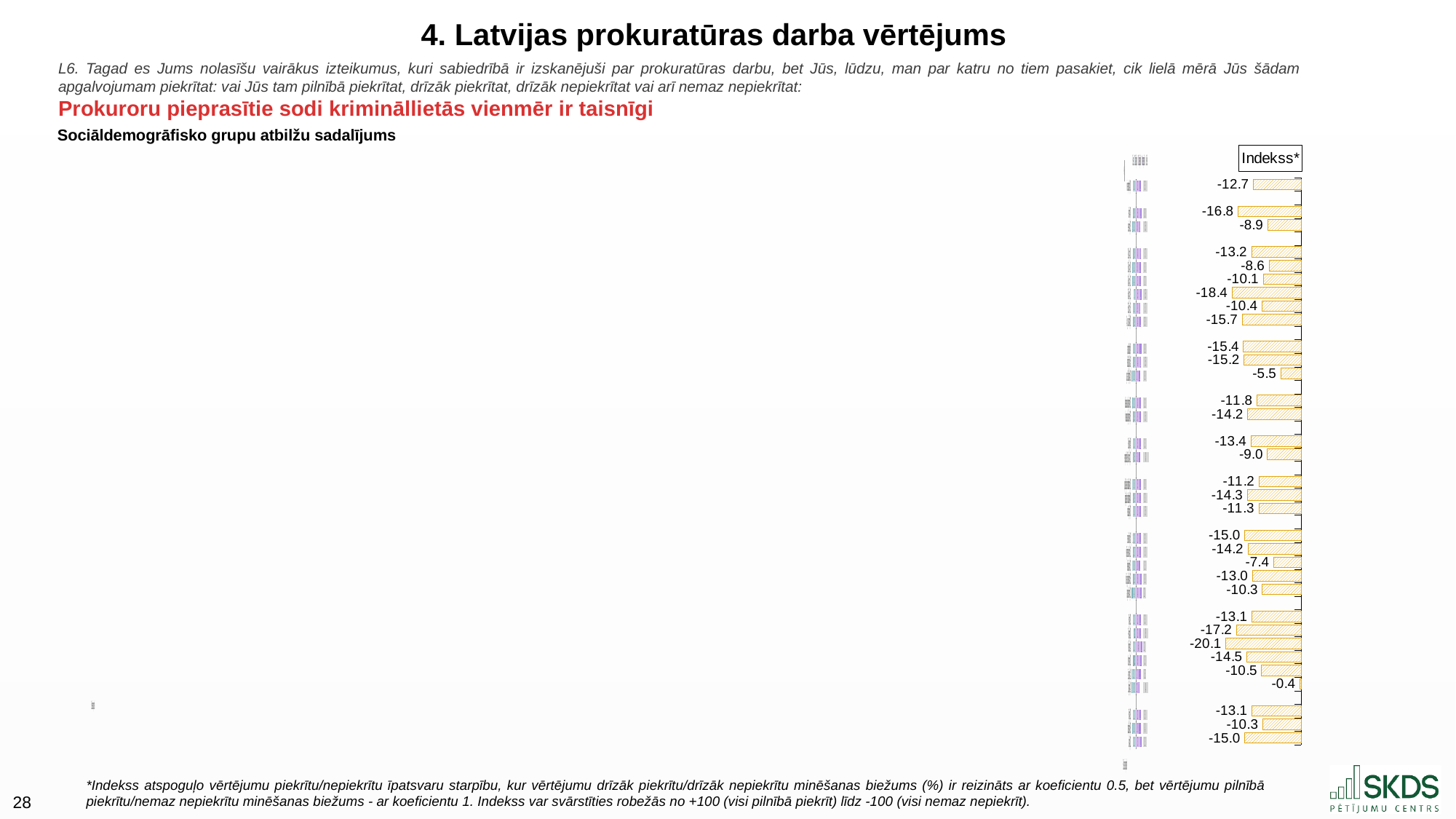
What is the index value of the bottommost bar in the Indekss* chart? -15.0 What is the heading printed above the index bars on the right side of the slide? Indekss* What is the index value of the topmost bar in the Indekss* chart? -12.7 How many index bars are shown in the Indekss* chart? 33 Are all the index values in the Indekss* chart negative or positive? negative Which is larger in the Indekss* chart: the topmost bar's value of -12.7 or the bottommost bar's value of -15.0? -12.7 What is the highest index value printed in the Indekss* chart? -0.4 What kind of chart is used to show the index values on the right side of the slide? bar chart What is the lowest index value printed in the Indekss* chart? -20.1 What is the difference between the highest index value (-0.4) and the lowest index value (-20.1) in the Indekss* chart? 19.7